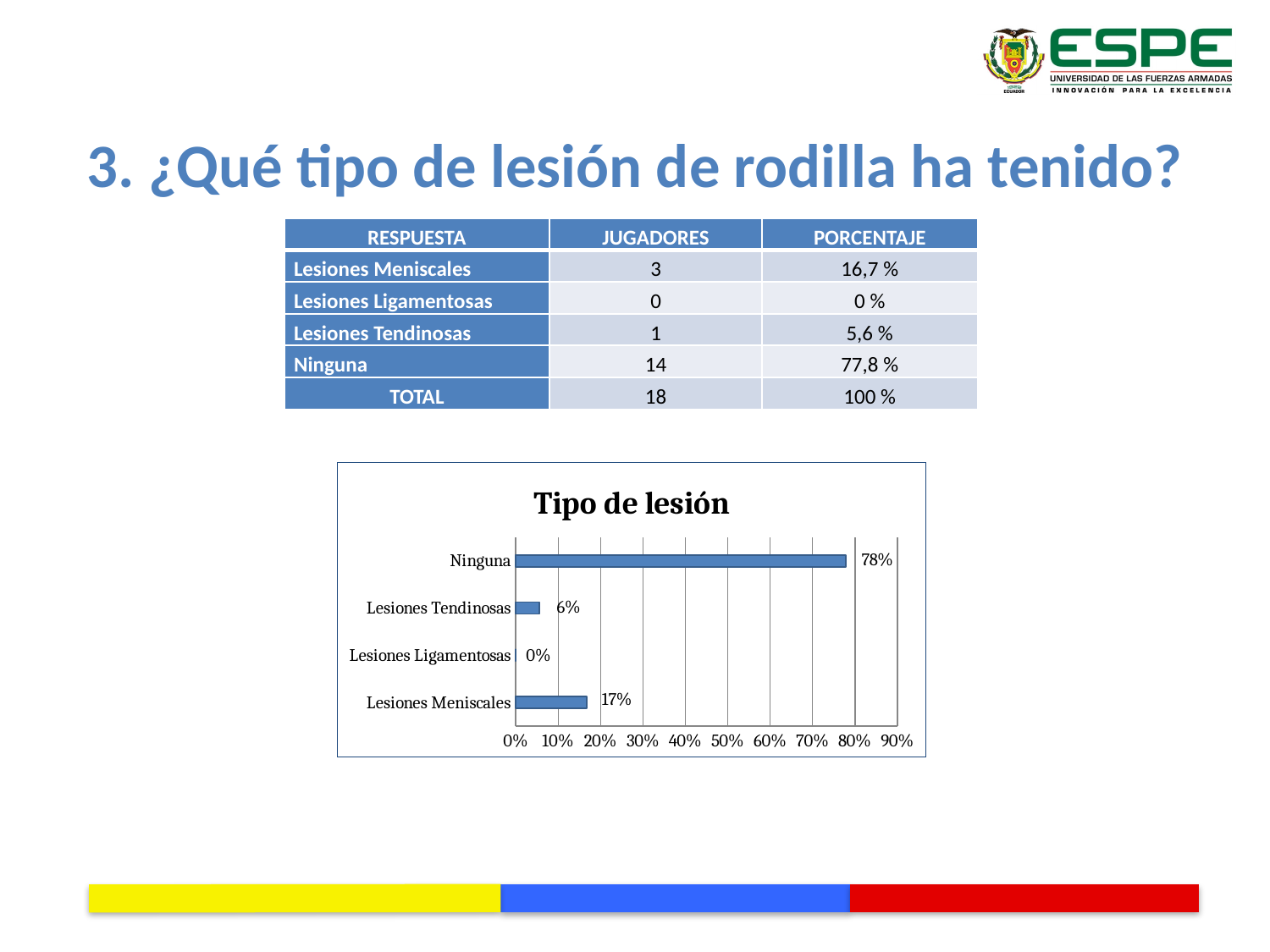
Which is larger, the value for Lesiones Meniscales or the value for Lesiones Tendinosas? Lesiones Meniscales What is the difference between the values for Ninguna and Lesiones Meniscales? 61% What is the value for Lesiones Ligamentosas in the chart? 0% What is the title of the chart? Tipo de lesión What is the value for Lesiones Tendinosas in the chart? 6% What is the value for Lesiones Meniscales in the chart? 17% What kind of chart is shown on the slide? bar chart How many categories are shown in the chart? 4 Which category has the highest value in the chart? Ninguna Is the value for Ninguna greater or less than 70%? greater What is the value for Ninguna in the chart? 78% Which category has the lowest value in the chart? Lesiones Ligamentosas